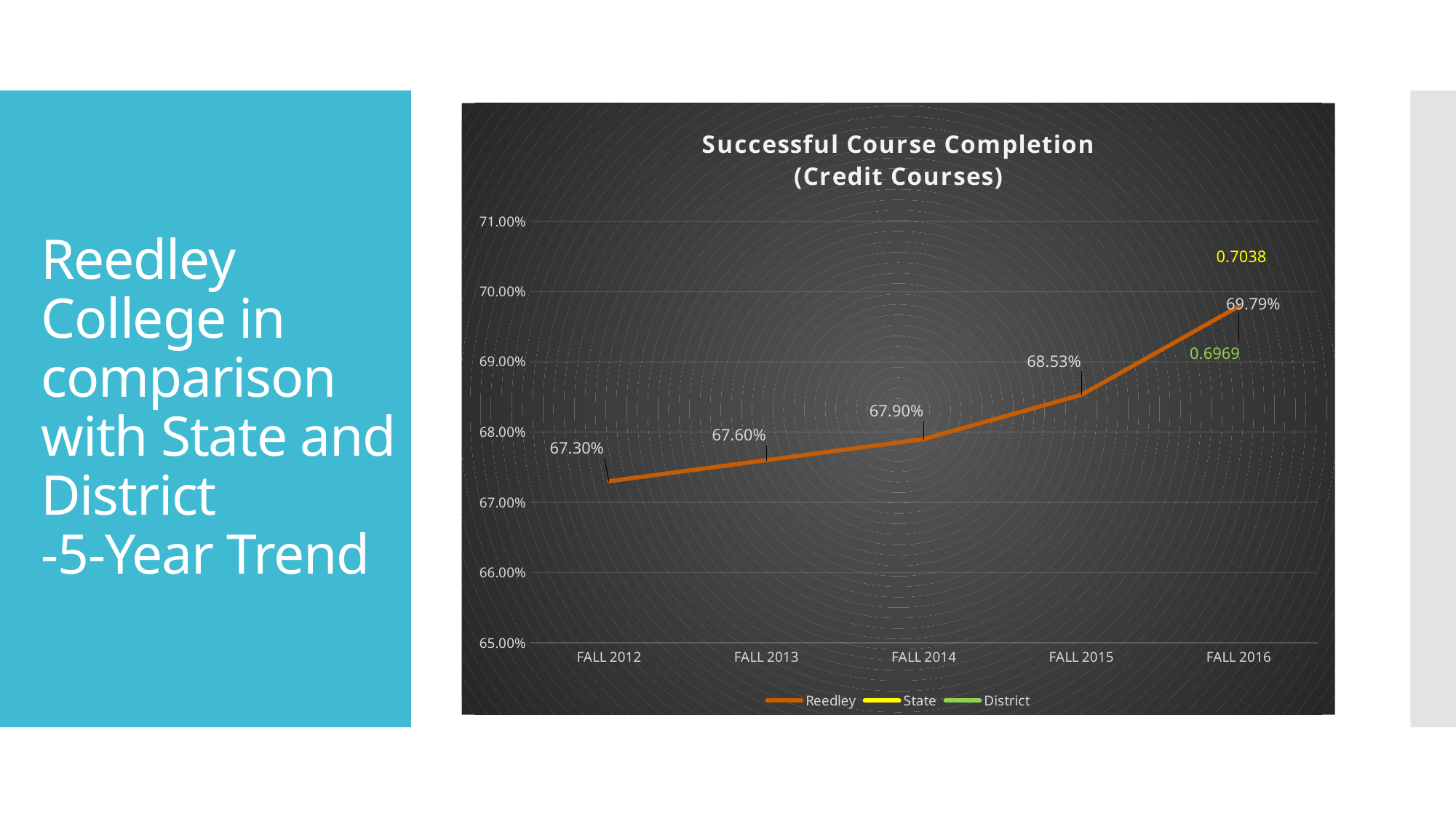
What is the Reedley successful course completion rate for Fall 2012? 67.30% What value is labelled for the State series at Fall 2016? 0.7038 In which term is the Reedley completion rate highest? Fall 2016 In which term is the Reedley completion rate lowest? Fall 2012 How many terms are shown on the x axis? 5 What type of chart is shown on the slide? line chart What is the title of the chart? Successful Course Completion (Credit Courses) What is the Reedley value for Fall 2014? 67.90% What is the Reedley value for Fall 2016? 69.79% Does the Reedley completion rate rise or fall from Fall 2012 to Fall 2016? rise What value is labelled for the District series at Fall 2016? 0.6969 How many series does the legend list? 3